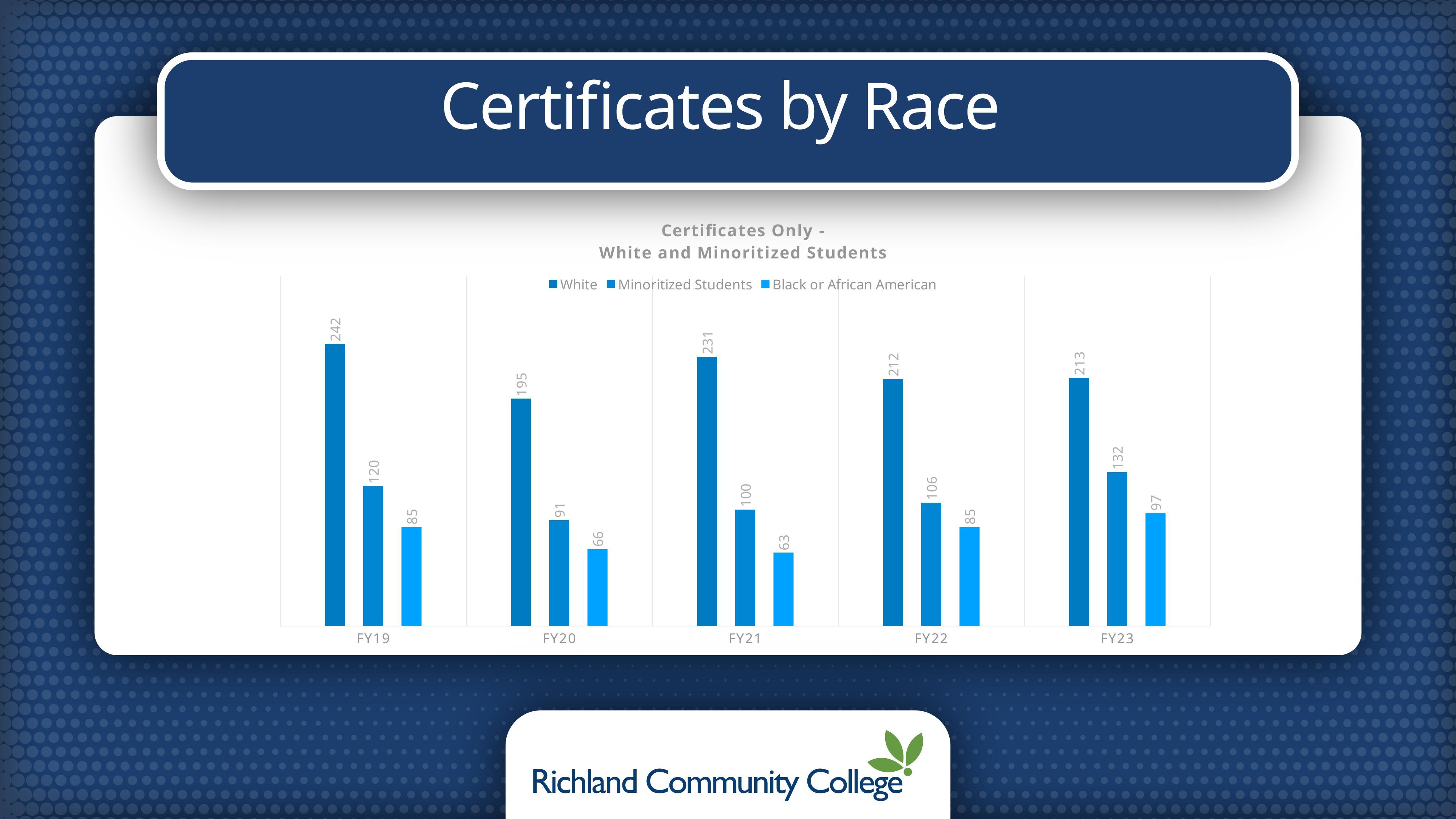
What is the title of the chart? Certificates Only - White and Minoritized Students What is the value for Minoritized Students in FY23? 132 What kind of chart is shown on the slide? Bar chart In which fiscal year is the Black or African American series lowest? FY21 What is the value for White in FY19? 242 What is the value for Black or African American in FY21? 63 In which fiscal year is the White series highest? FY19 What is the difference between the White and Minoritized Students values in FY22? 106 How many series does the legend list? 3 Does the Minoritized Students series rise or fall from FY21 to FY23? Rise Which is larger: Minoritized Students in FY19 or Minoritized Students in FY20? Minoritized Students in FY19 How many fiscal years are shown on the x axis? 5